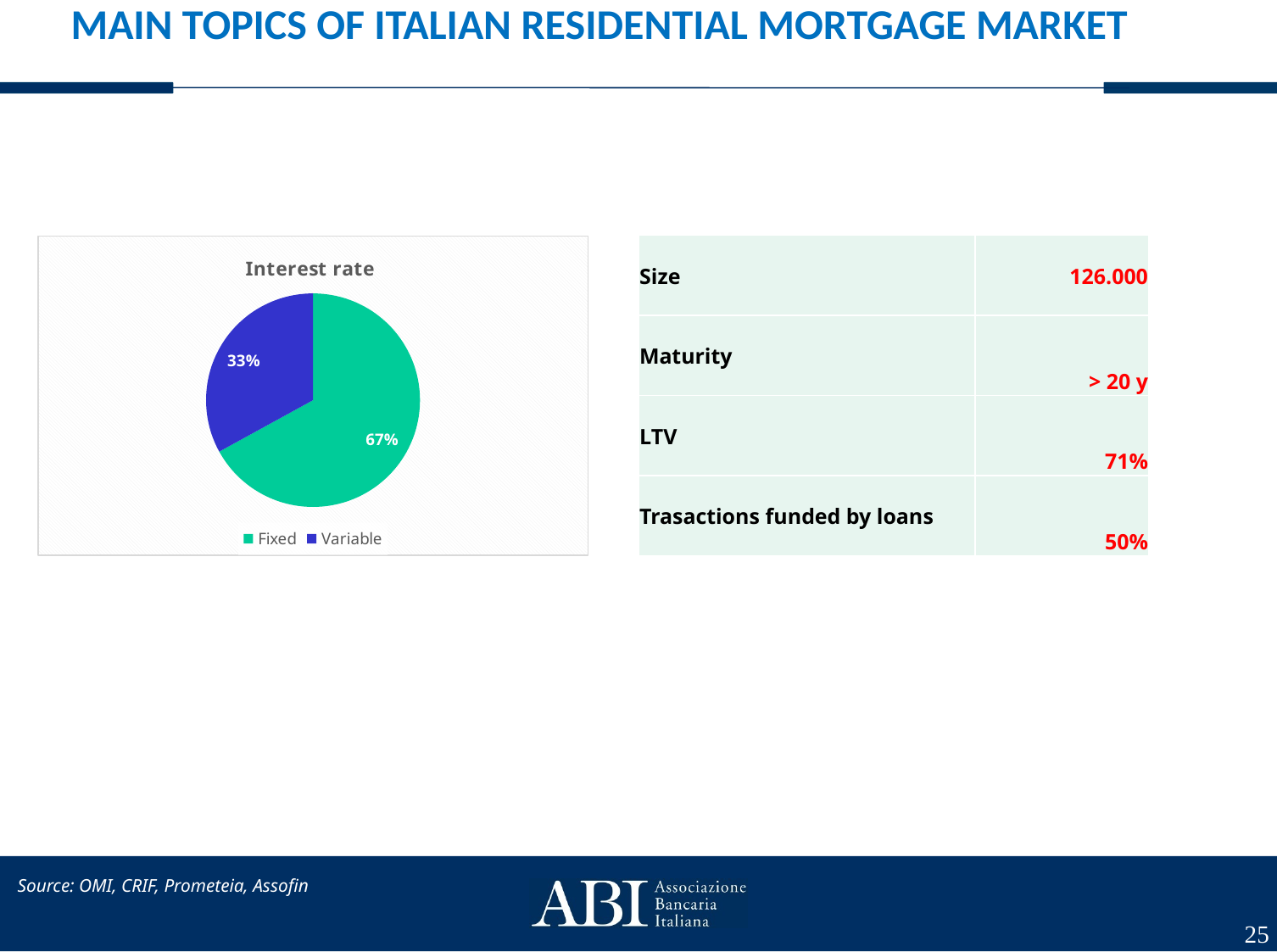
How many slices does the "Interest rate" pie have? 2 What colour is the Variable slice in the "Interest rate" pie? blue What share of the "Interest rate" pie is Variable? 33% In the "Interest rate" pie, which is larger, Fixed or Variable? Fixed What share of the "Interest rate" pie is Fixed? 67% Which slice of the "Interest rate" pie is the largest? Fixed Which slice of the "Interest rate" pie is the smallest? Variable How many entries does the legend of the "Interest rate" chart list? 2 Is the Fixed share in the "Interest rate" pie greater or less than 50%? greater What is the title of the pie chart? Interest rate What is the difference in percentage points between the Fixed and Variable slices of the "Interest rate" pie? 34 What kind of chart is the "Interest rate" chart? pie chart